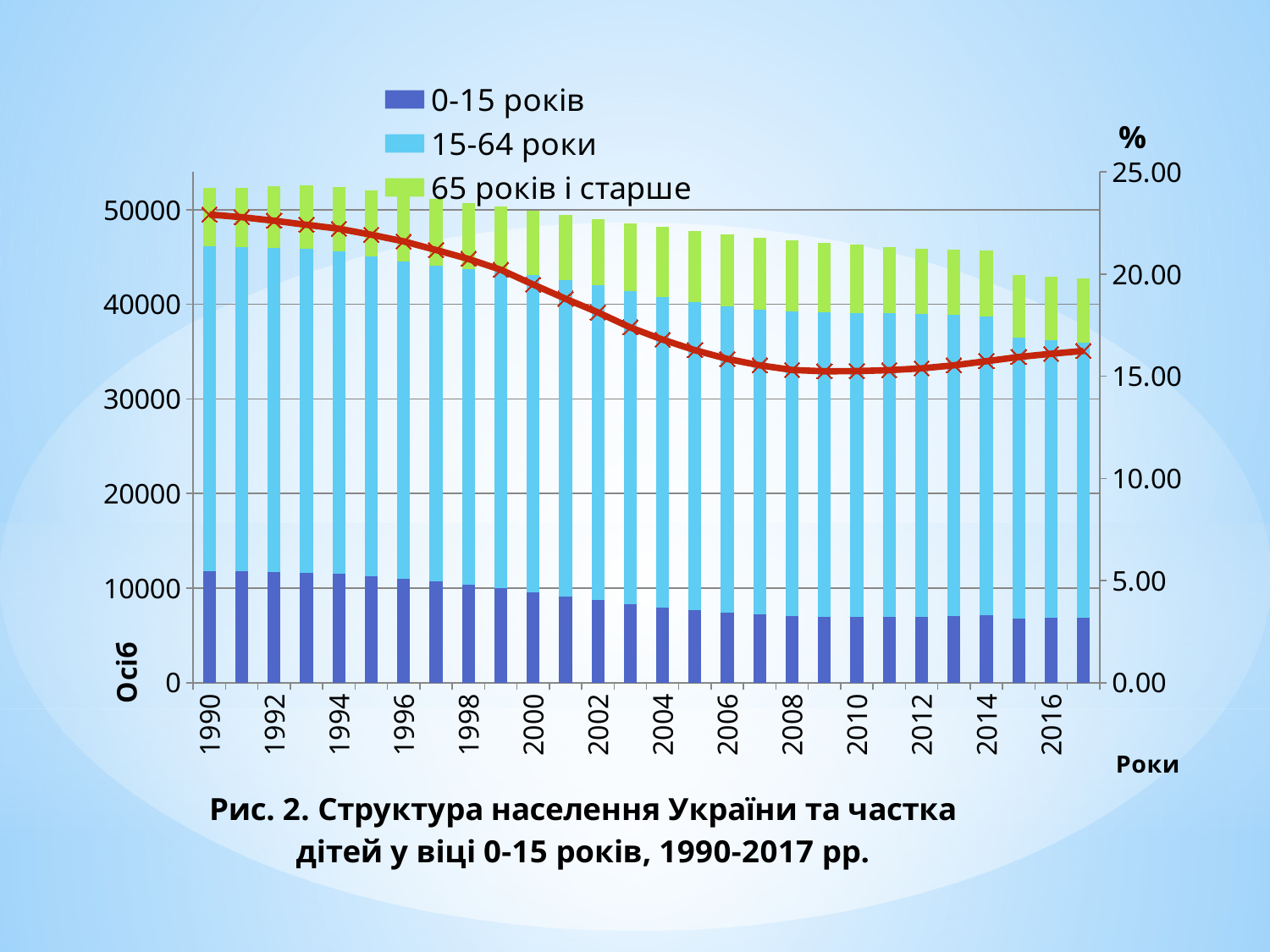
Does the red line rise or fall from 1990 to 2009? fall How many series does the legend list? 3 Is the total height of the stacked bar for 2017 greater or less than 50000? less Is the red line value for 1990 greater or less than 20.00 on the right (%) axis? greater Is the value of the 0-15 років series in 2017 greater or less than 10000? less How many years (bars) are plotted along the x axis? 28 What kind of chart is shown on the slide? Stacked bar chart with a line What is the label of the left vertical axis? Осіб Which series does the legend list first? 0-15 років Which year has the larger value for the 0-15 років series, 1990 or 2017? 1990